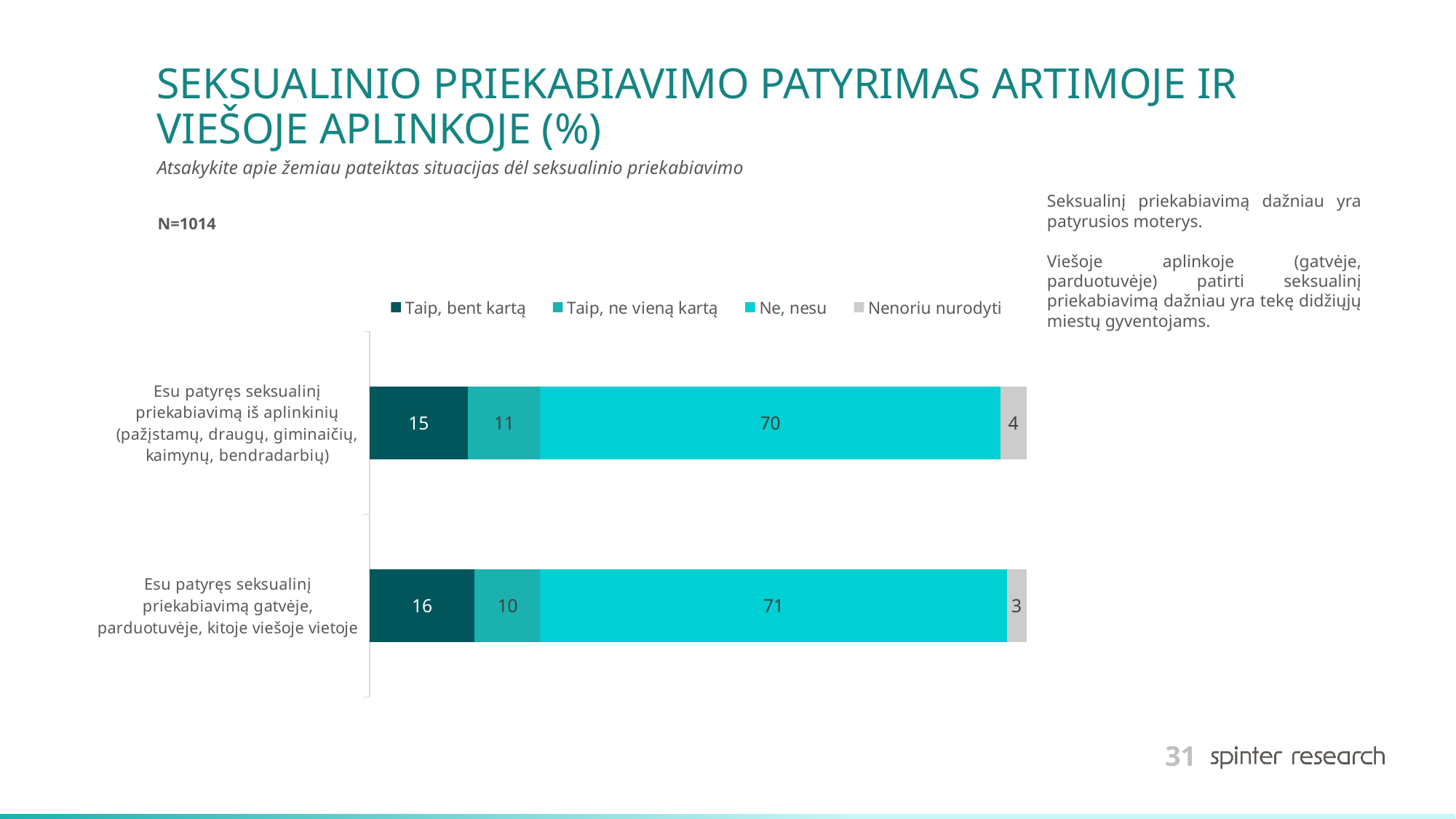
How many series does the legend list? 4 Which category has the higher value for "Taip, bent kartą"? Esu patyręs seksualinį priekabiavimą gatvėje, parduotuvėje, kitoje viešoje vietoje What is the total of the stacked bar for "Esu patyręs seksualinį priekabiavimą gatvėje, parduotuvėje, kitoje viešoje vietoje"? 100 What is the value of "Taip, ne vieną kartą" for "Esu patyręs seksualinį priekabiavimą gatvėje, parduotuvėje, kitoje viešoje vietoje"? 10 Which series has the largest segment in the bar for "Esu patyręs seksualinį priekabiavimą iš aplinkinių (pažįstamų, draugų, giminaičių, kaimynų, bendradarbių)"? Ne, nesu What kind of chart is shown on the slide? Stacked bar chart How many categories (bars) are plotted in the chart? 2 What is the value of "Ne, nesu" for "Esu patyręs seksualinį priekabiavimą gatvėje, parduotuvėje, kitoje viešoje vietoje"? 71 What is the value of "Nenoriu nurodyti" for "Esu patyręs seksualinį priekabiavimą iš aplinkinių (pažįstamų, draugų, giminaičių, kaimynų, bendradarbių)"? 4 What sample size (N) is stated on the slide? N=1014 What is the value of "Taip, bent kartą" for "Esu patyręs seksualinį priekabiavimą iš aplinkinių (pažįstamų, draugų, giminaičių, kaimynų, bendradarbių)"? 15 What is the difference between the "Ne, nesu" values of the two categories? 1